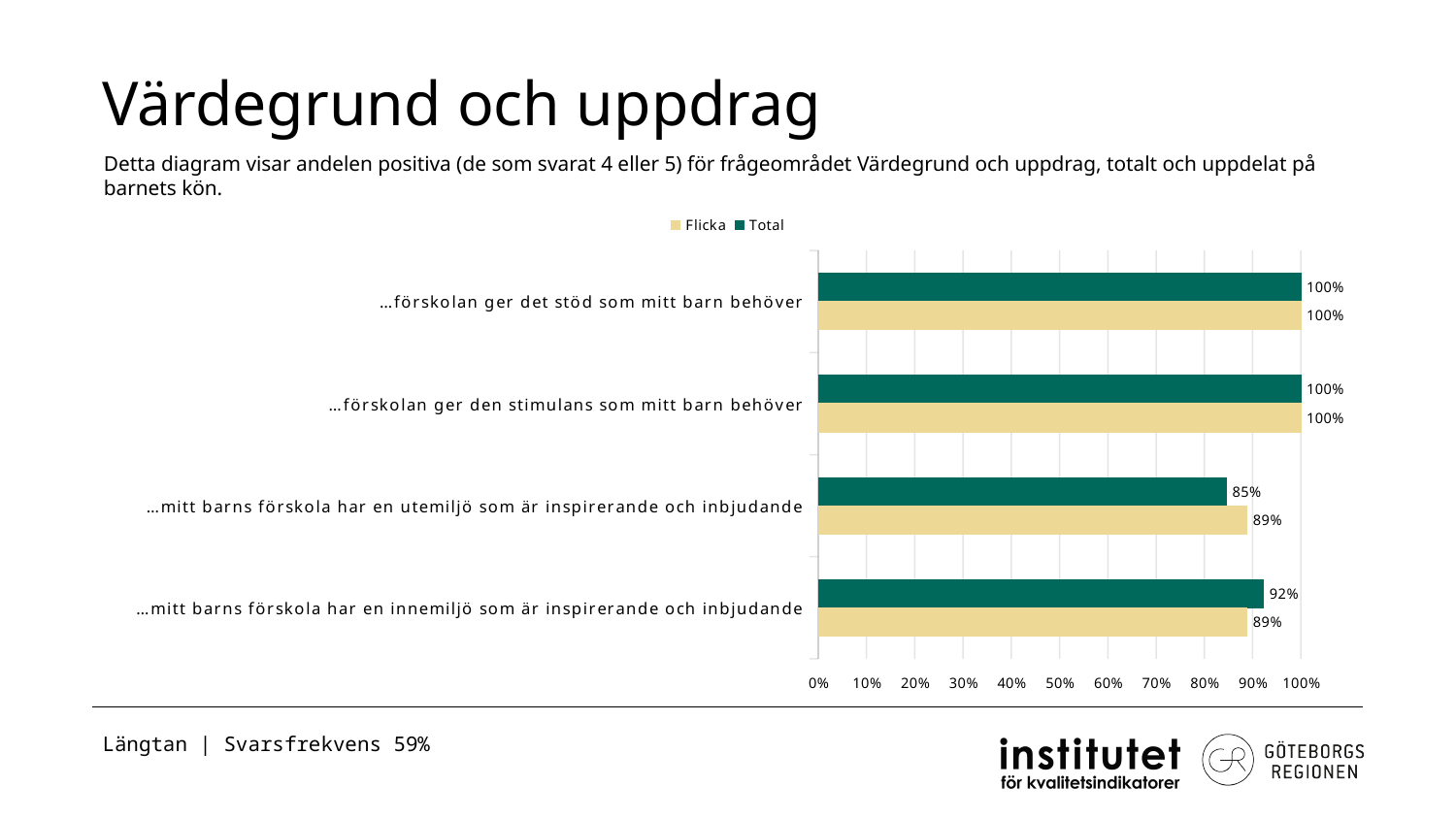
What is the Total value for "…förskolan ger den stimulans som mitt barn behöver"? 100% What is the Total value for "…mitt barns förskola har en utemiljö som är inspirerande och inbjudande"? 85% How many series does the legend list? 2 What is the Flicka value for "…mitt barns förskola har en innemiljö som är inspirerande och inbjudande"? 89% What is the Flicka value for "…mitt barns förskola har en utemiljö som är inspirerande och inbjudande"? 89% What is the difference between the Total values for the innemiljö statement and the utemiljö statement? 7% What kind of chart is shown on the slide? bar chart Which colour represents the Total series in the chart? green For "…mitt barns förskola har en innemiljö som är inspirerande och inbjudande", which is larger, the Total value or the Flicka value? Total Which category has the lowest Total value? …mitt barns förskola har en utemiljö som är inspirerande och inbjudande For "…mitt barns förskola har en utemiljö som är inspirerande och inbjudande", which is larger, the Flicka value or the Total value? Flicka How many categories (statements) are plotted in the chart? 4